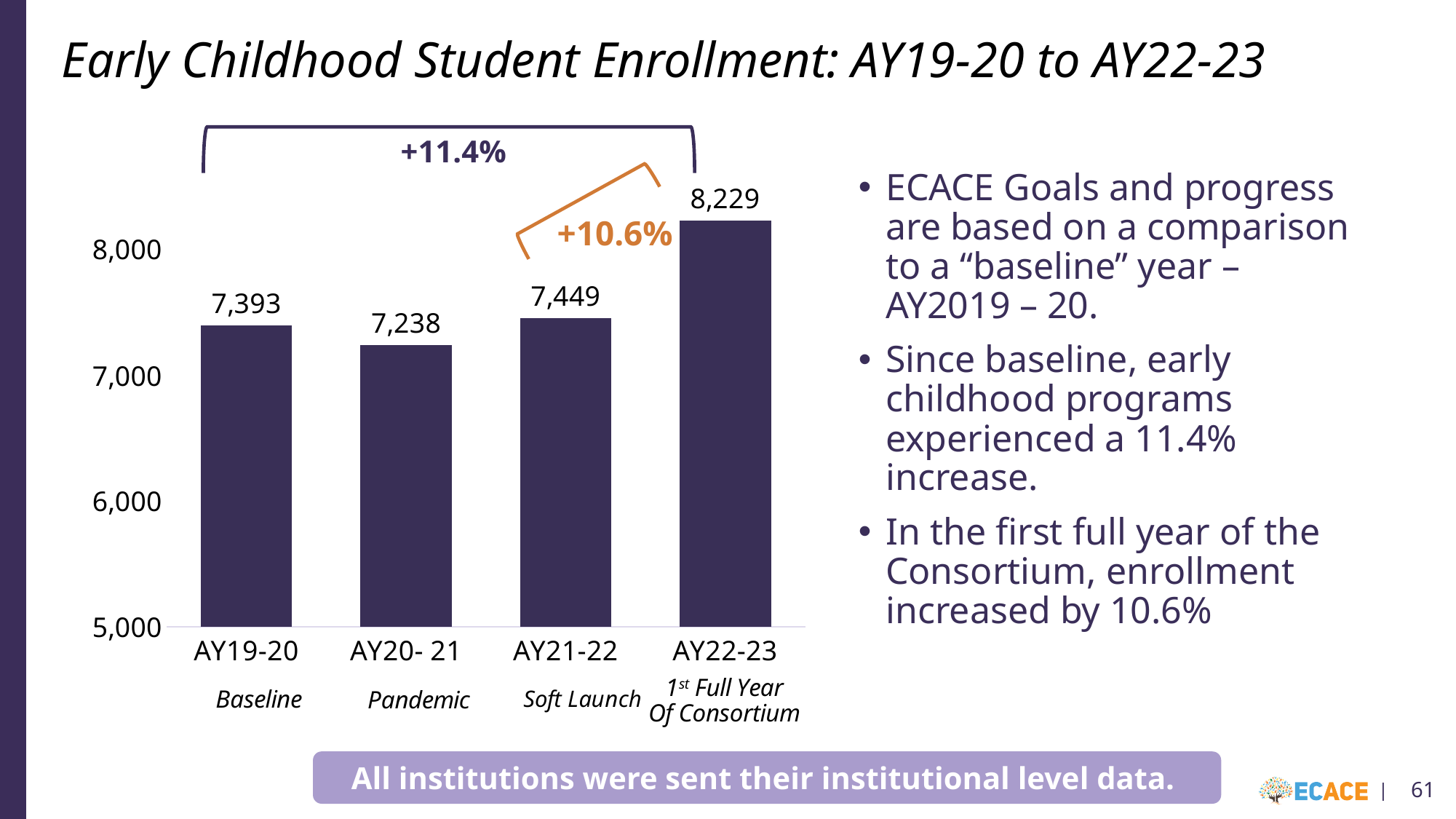
What is the difference in enrollment between AY22-23 and AY21-22? 780 What is the difference in enrollment between AY19-20 and AY20-21? 155 What is the enrollment value for AY20-21? 7,238 Which is larger, the enrollment for AY19-20 or AY21-22? AY21-22 How many academic years are shown in the chart? 4 What kind of chart is shown on the slide? bar chart What is the enrollment value for AY19-20? 7,393 Which academic year has the highest enrollment? AY22-23 What is the enrollment value for AY22-23? 8,229 Is the enrollment value for AY22-23 greater or less than 8,000? greater What percentage increase is annotated between AY19-20 and AY22-23? +11.4% Which academic year has the lowest enrollment? AY20-21